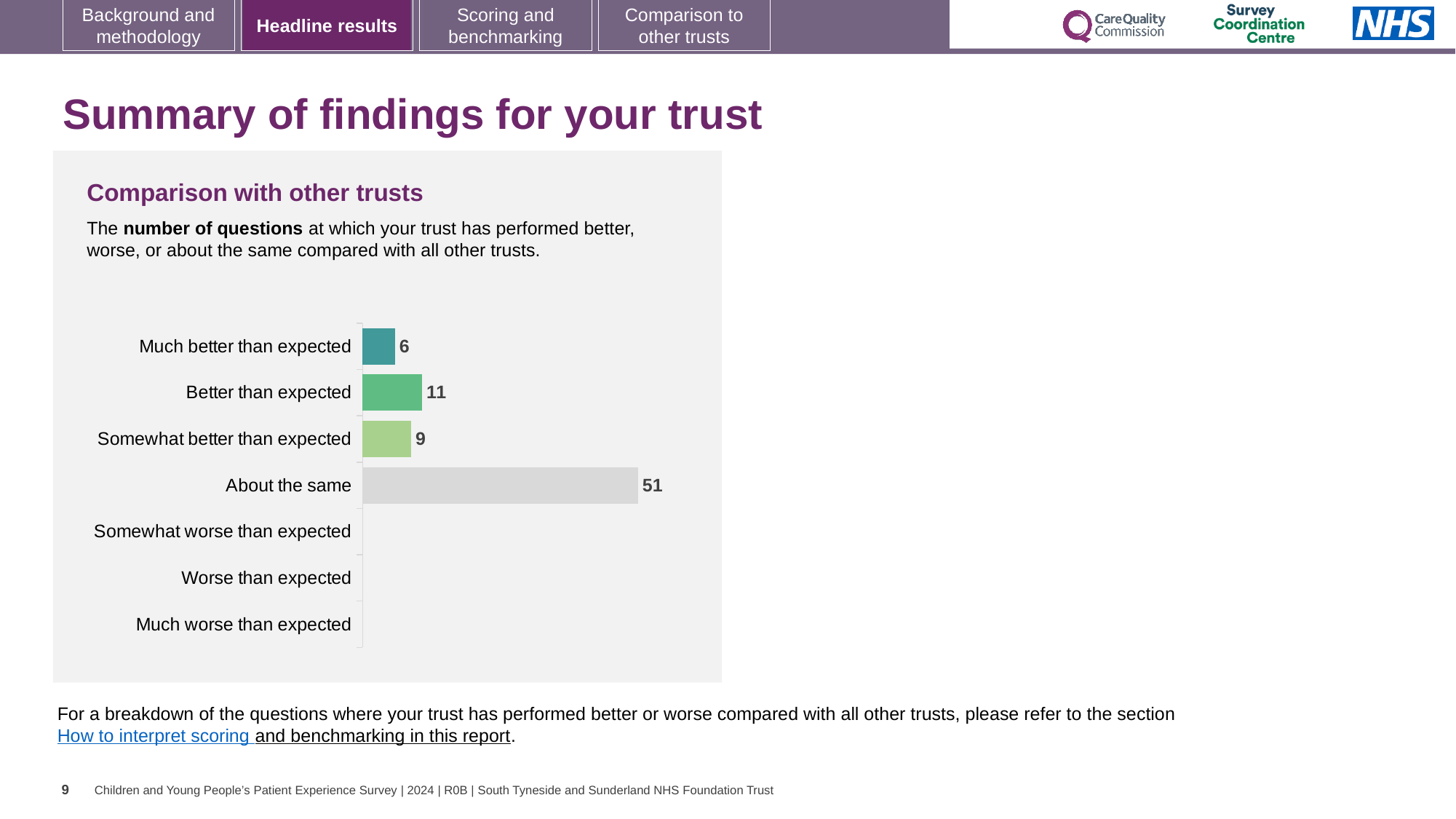
What is the value for 'About the same'? 51 Which category has the highest value? About the same What kind of chart is shown on the slide? Bar chart What is the title of the chart section? Comparison with other trusts What is the value for 'Somewhat better than expected'? 9 What is the value for 'Better than expected'? 11 Which is larger, the value for 'Better than expected' or 'Much better than expected'? Better than expected How many categories are listed on the chart's axis? 7 What is the value for 'Much better than expected'? 6 Which category has the lowest value among those with a bar shown? Much better than expected What is the difference between the values for 'Better than expected' and 'Somewhat better than expected'? 2 What is the difference between the values for 'About the same' and 'Better than expected'? 40